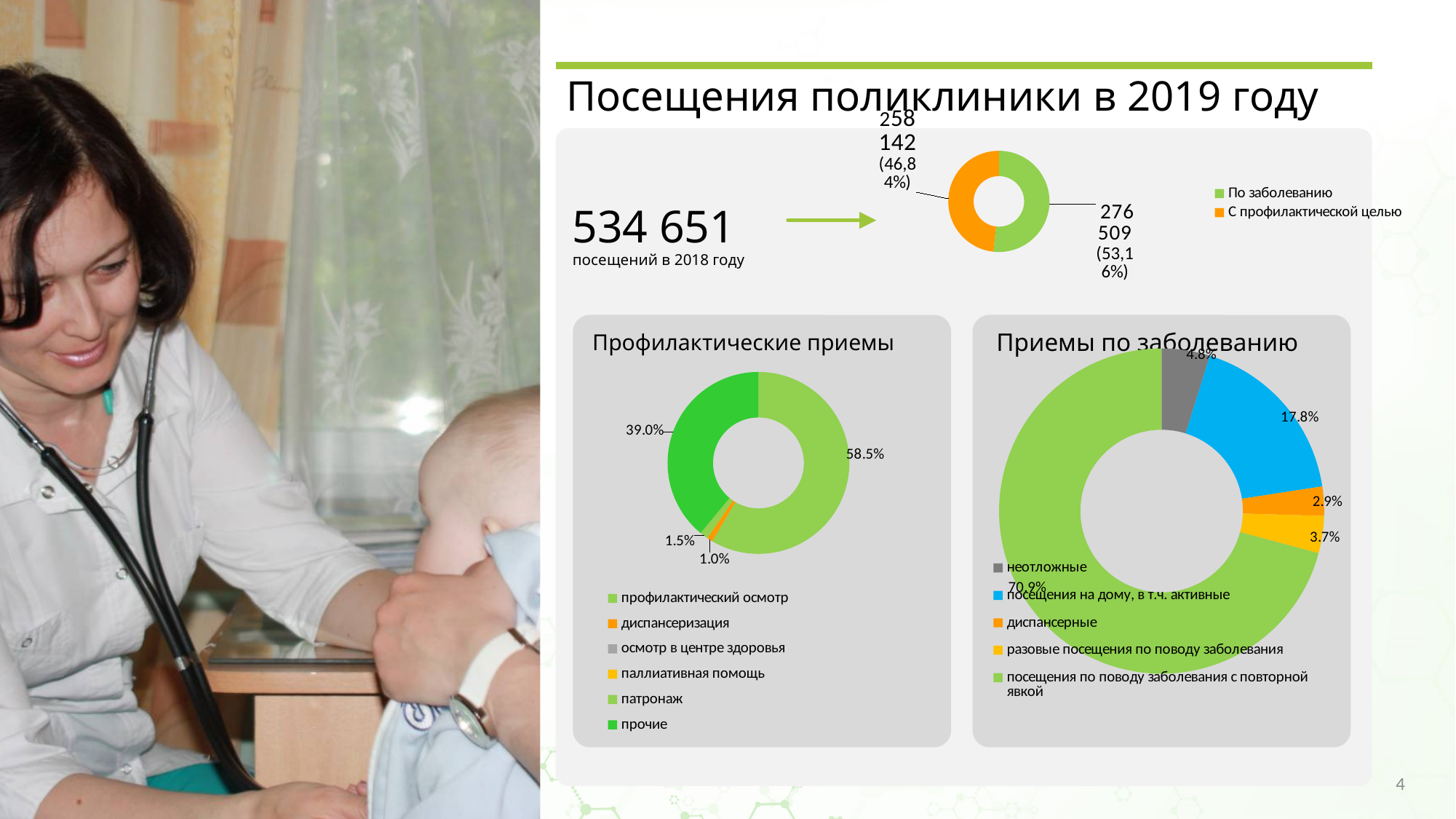
On the top doughnut chart, what is the number of visits for 'С профилактической целью'? 258 142 On the top doughnut chart, what is the number of visits for 'По заболеванию'? 276 509 On the 'Приемы по заболеванию' chart, what percentage is shown for 'посещения на дому, в т.ч. активные'? 17.8% On the 'Профилактические приемы' chart, how many entries does the legend list? 6 On the top doughnut chart, what percentage share is shown for 'По заболеванию'? 53,16% What type of chart is 'Приемы по заболеванию'? Doughnut (pie) chart On the 'Профилактические приемы' chart, what percentage is shown for 'прочие'? 39.0% On the 'Приемы по заболеванию' chart, what percentage is shown for 'неотложные'? 4.8% On the 'Приемы по заболеванию' chart, which category has the largest share? посещения по поводу заболевания с повторной явкой On the 'Профилактические приемы' chart, what percentage is shown for 'профилактический осмотр'? 58.5% On the top doughnut chart, what is the difference between the visits 'По заболеванию' and 'С профилактической целью'? 18 367 On the top doughnut chart, which category is larger: 'По заболеванию' or 'С профилактической целью'? По заболеванию